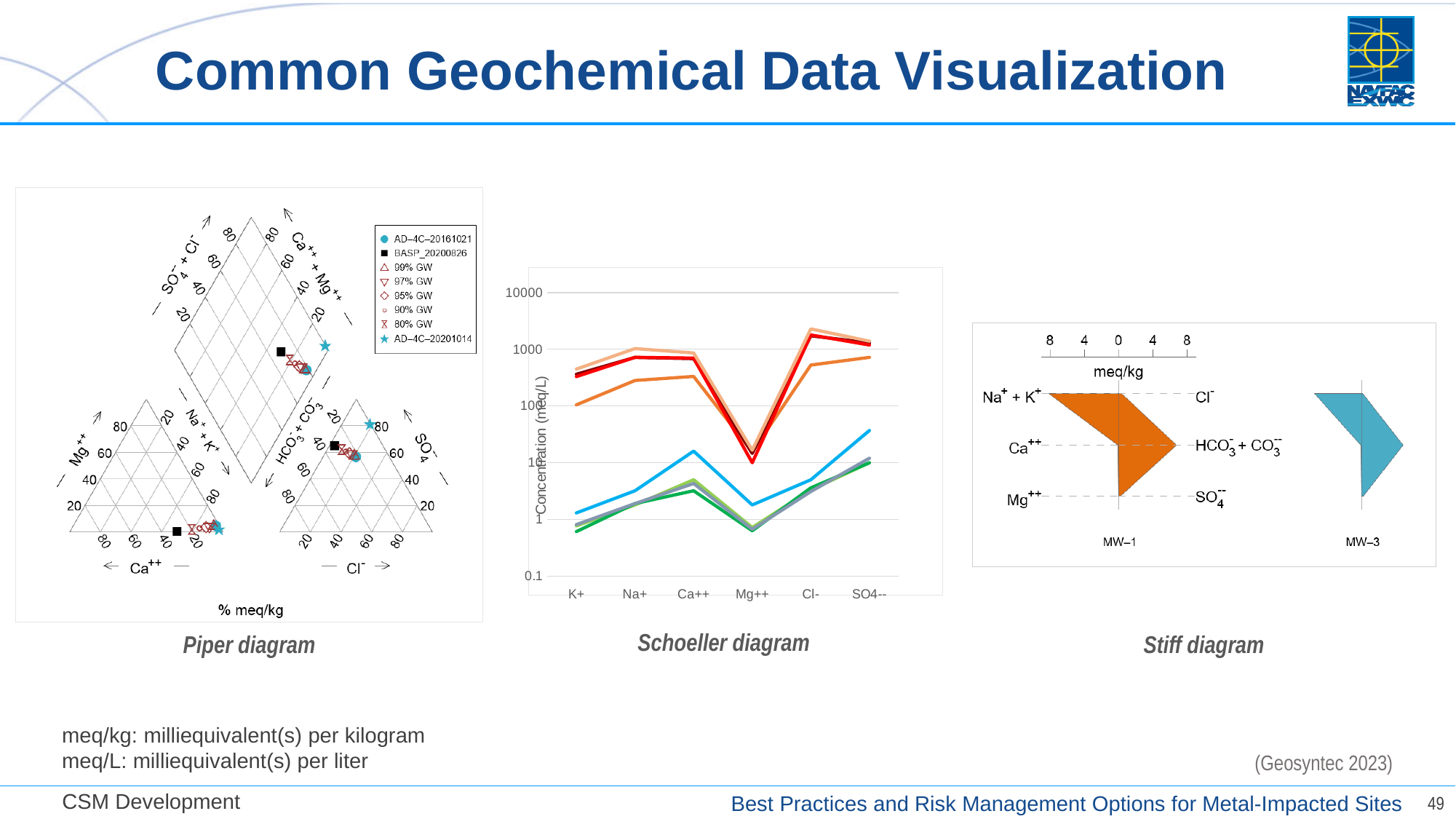
In the Schoeller diagram, is the value of the dark green line at Ca++ greater or less than 10? less What kind of chart is the Schoeller diagram? line chart In the Schoeller diagram, is the value of the topmost (light orange) line at Cl- greater or less than 1000? greater In the Schoeller diagram, do the lines rise or fall from Mg++ to Cl-? rise In the Schoeller diagram, which is larger at Na+: the red line or the light blue line? the red line In the Schoeller diagram, is the value of the red line at Mg++ greater or less than 100? less Which two wells are shown in the Stiff diagram? MW-1 and MW-3 How many entries does the legend of the Piper diagram list? 8 How many categories are shown on the x axis of the Schoeller diagram? 6 What is the y-axis label of the Schoeller diagram? Concentration (meq/L)